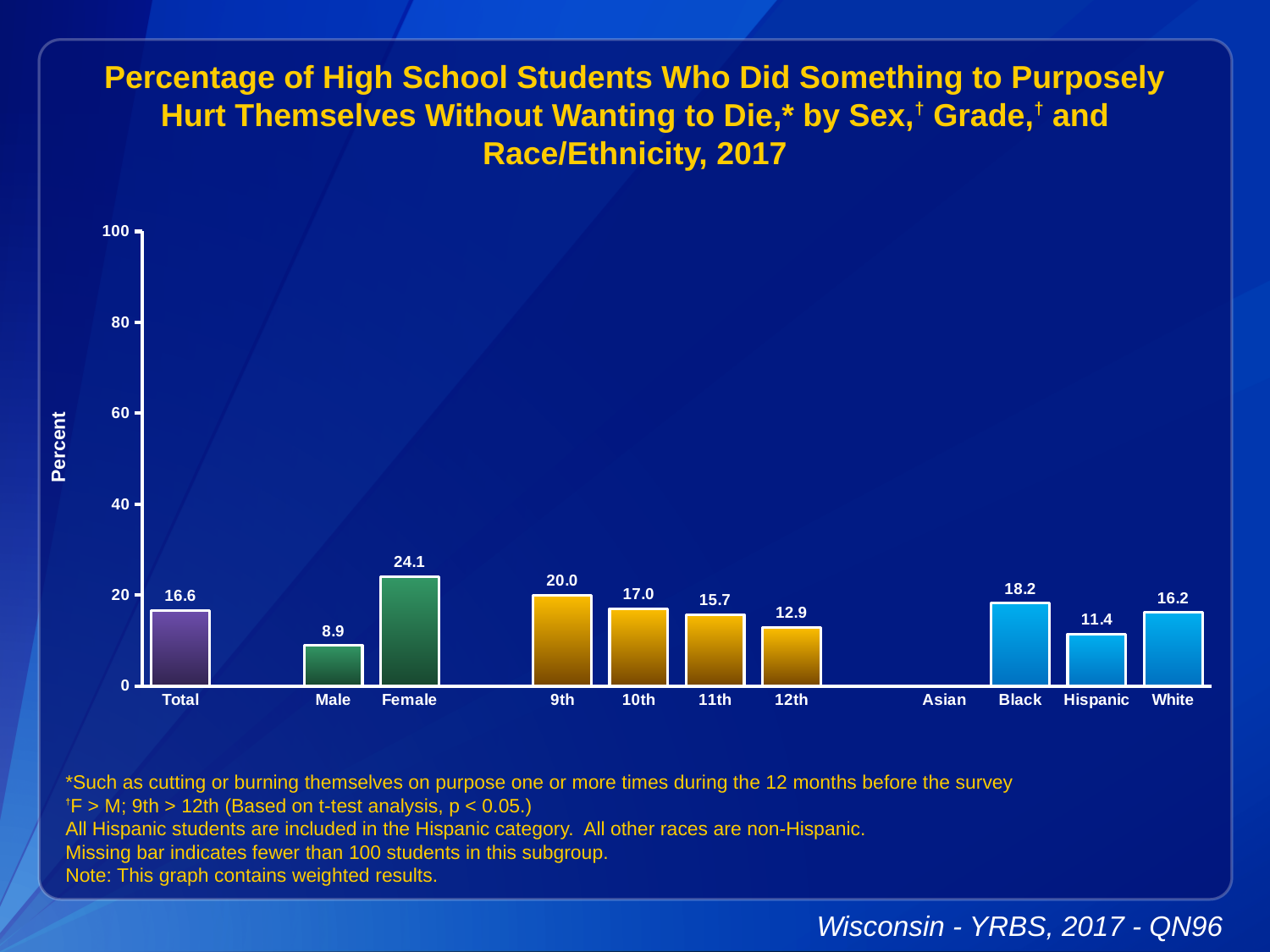
Which category has the lowest plotted value? Male Which is larger, the value for 9th grade or the value for 12th grade? 9th What is the value for Total? 16.6 What is the difference between the Female and Male values? 15.2 Which category has the highest value? Female What is the value for 12th grade? 12.9 Is the value for Black greater or less than 20? less What is the value for Hispanic? 11.4 Which category on the x axis has no bar plotted? Asian Do the values rise or fall from 9th grade to 12th grade? fall What kind of chart is shown on the slide? bar chart What is the value for Female? 24.1